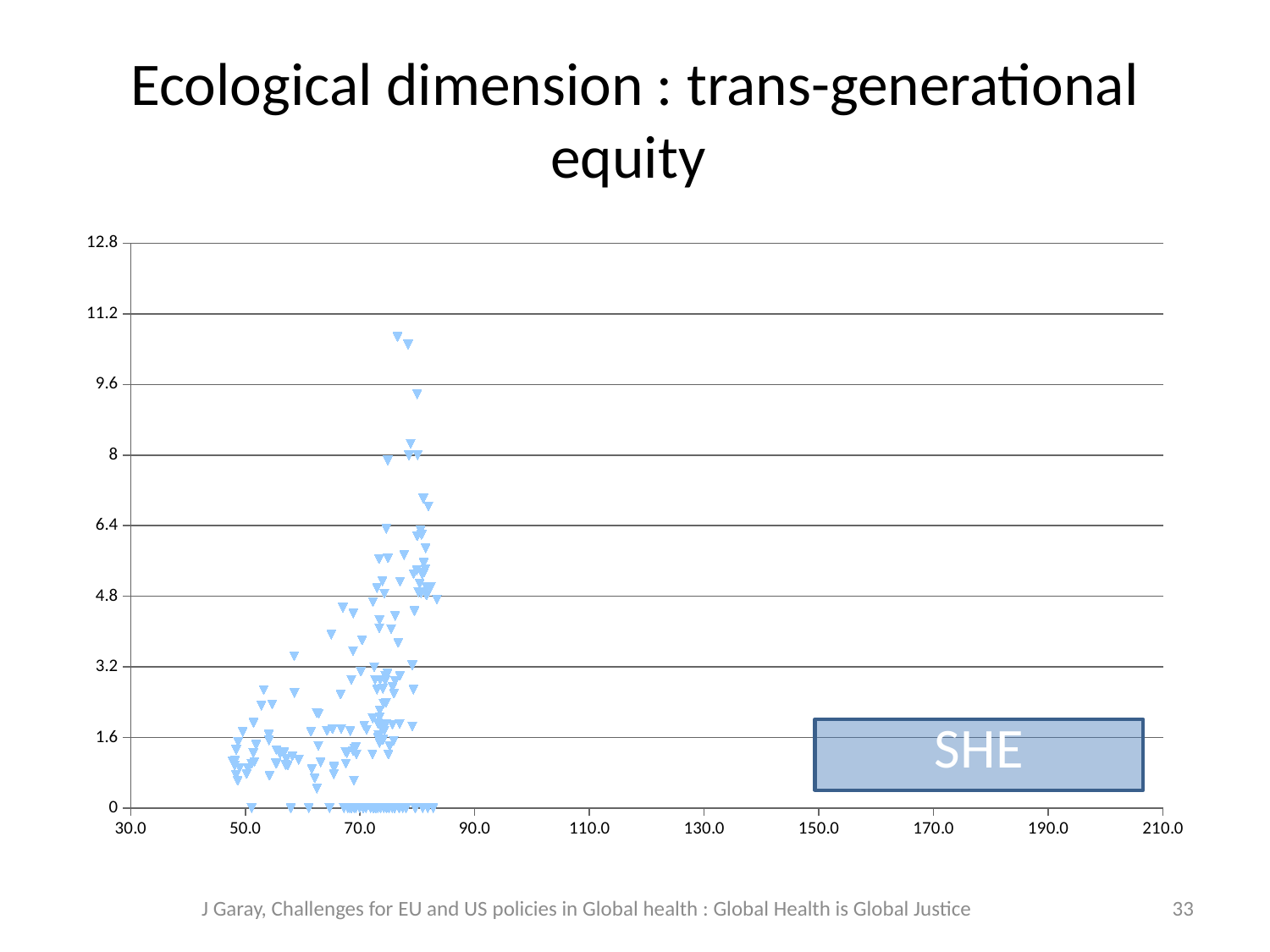
Are all the plotted points located at x-axis values less than or greater than 90.0? less What kind of chart is shown on the slide? scatter chart What is the highest value shown on the y axis of the chart? 12.8 Do the plotted values generally rise or fall as the x-axis value increases? rise Is the highest plotted point on the chart greater or less than 9.6 on the y axis? greater What is the lowest value shown on the x axis of the chart? 30.0